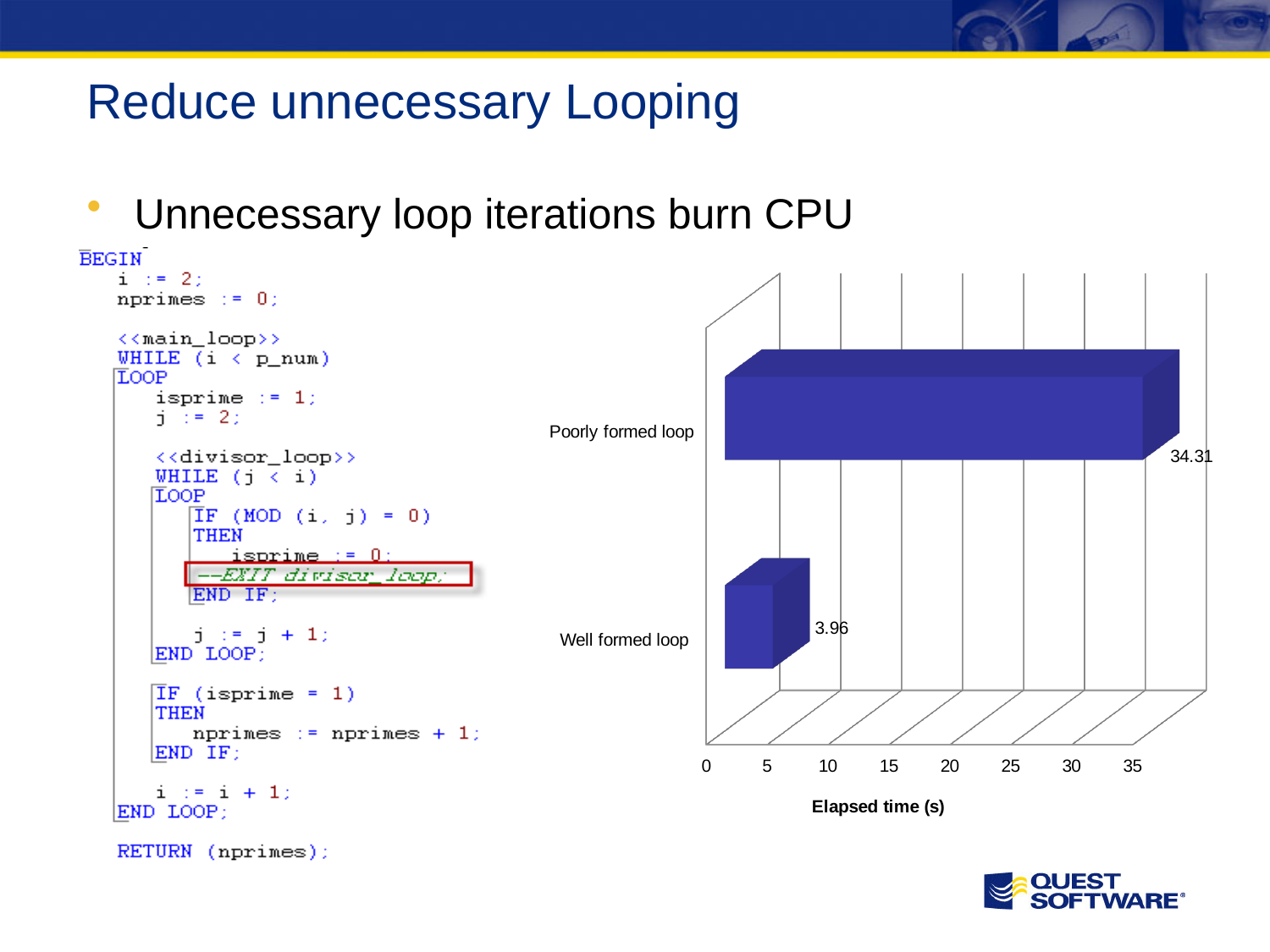
What is the maximum value shown on the horizontal axis of the chart? 35 What is the elapsed time for the well formed loop? 3.96 How many categories are shown in the chart? 2 Which loop has the lower elapsed time? Well formed loop Is the elapsed time for the well formed loop greater or less than 5? less Which loop has the higher elapsed time? Poorly formed loop Is the elapsed time for the poorly formed loop greater or less than 30? greater What is the label of the horizontal axis of the chart? Elapsed time (s) What is the elapsed time for the poorly formed loop? 34.31 What kind of chart is shown on the slide? Bar chart What is the difference in elapsed time between the poorly formed loop and the well formed loop? 30.35